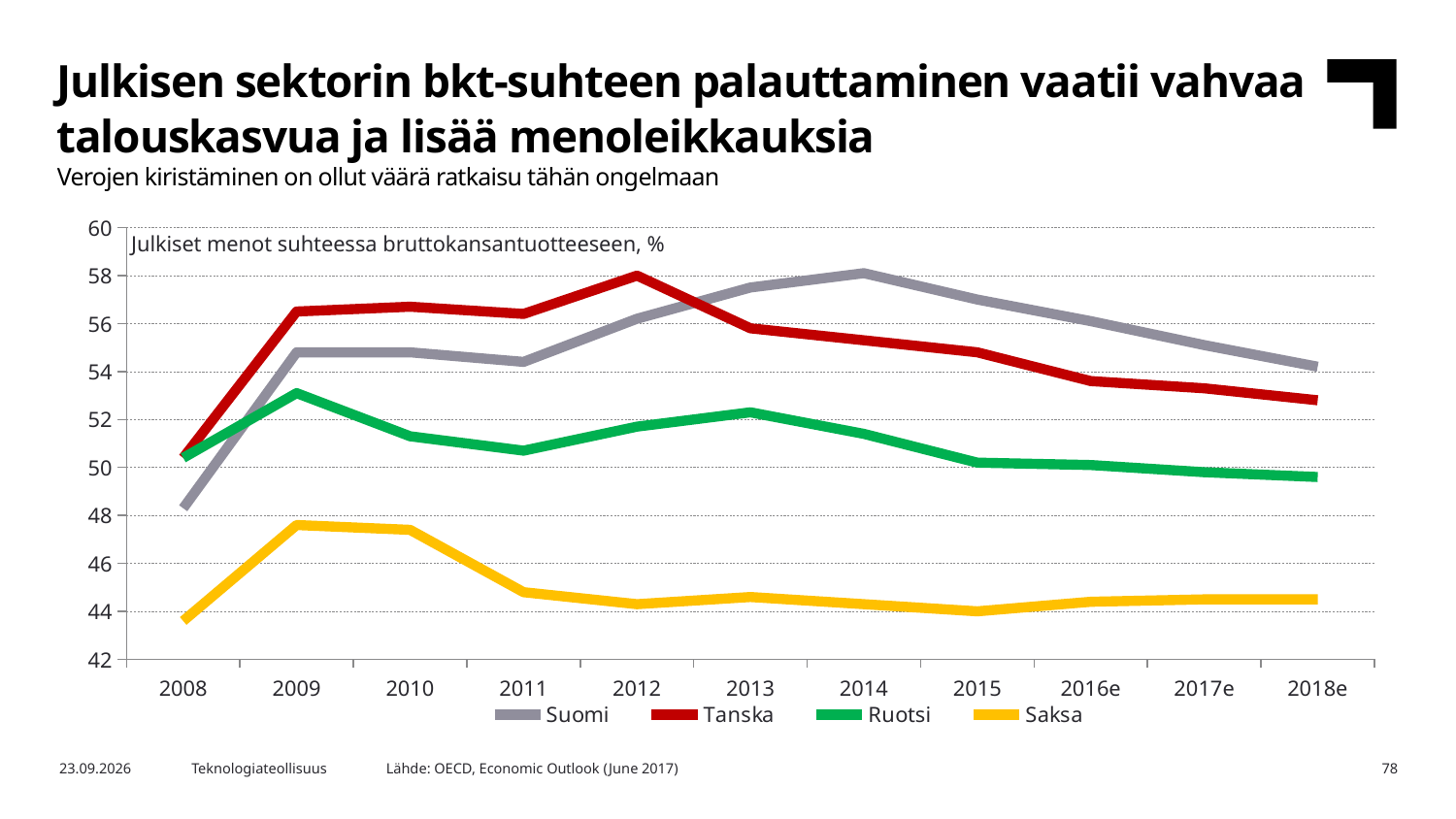
What label is printed inside the chart area describing the plotted measure? Julkiset menot suhteessa bruttokansantuotteeseen, % Which countries are listed in the legend? Suomi, Tanska, Ruotsi, Saksa How many series does the legend list? 4 Which series has the lowest value in 2018e? Saksa In 2014, which is higher, Suomi or Tanska? Suomi What kind of chart is shown on the slide? line chart Is the value for Tanska in 2012 greater or less than 56? greater Is the value for Suomi in 2008 greater or less than 50? less Is the value for Saksa in 2009 greater or less than 46? greater How many years are shown on the x axis? 11 Which series has the highest value in 2012? Tanska Does the Suomi line rise or fall from 2014 to 2018e? fall